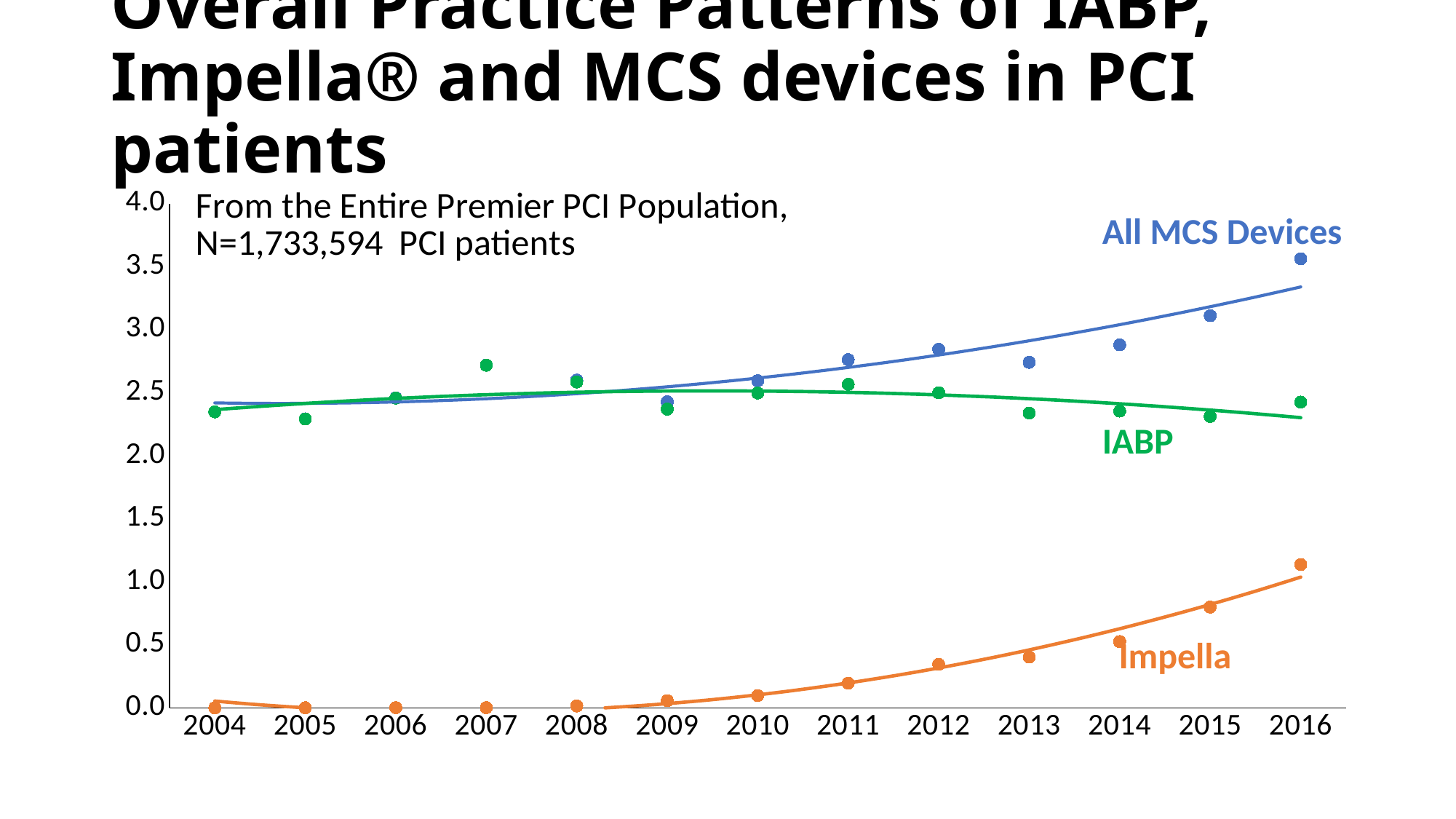
How many series are plotted on the chart? 3 In which year is the All MCS Devices value highest? 2016 What is the N of PCI patients stated on the chart? N=1,733,594 In which year is the Impella value highest? 2016 What kind of chart is shown on the slide? scatter chart with trend lines Do the Impella values generally rise or fall from 2009 to 2016? rise Is the value for Impella in 2004 greater or less than 0.5? less Is the value for All MCS Devices in 2016 greater or less than 3.0? greater Is the value for IABP in 2016 greater or less than 3.0? less How many years are shown along the x axis? 13 In 2016, which is larger: All MCS Devices or IABP? All MCS Devices